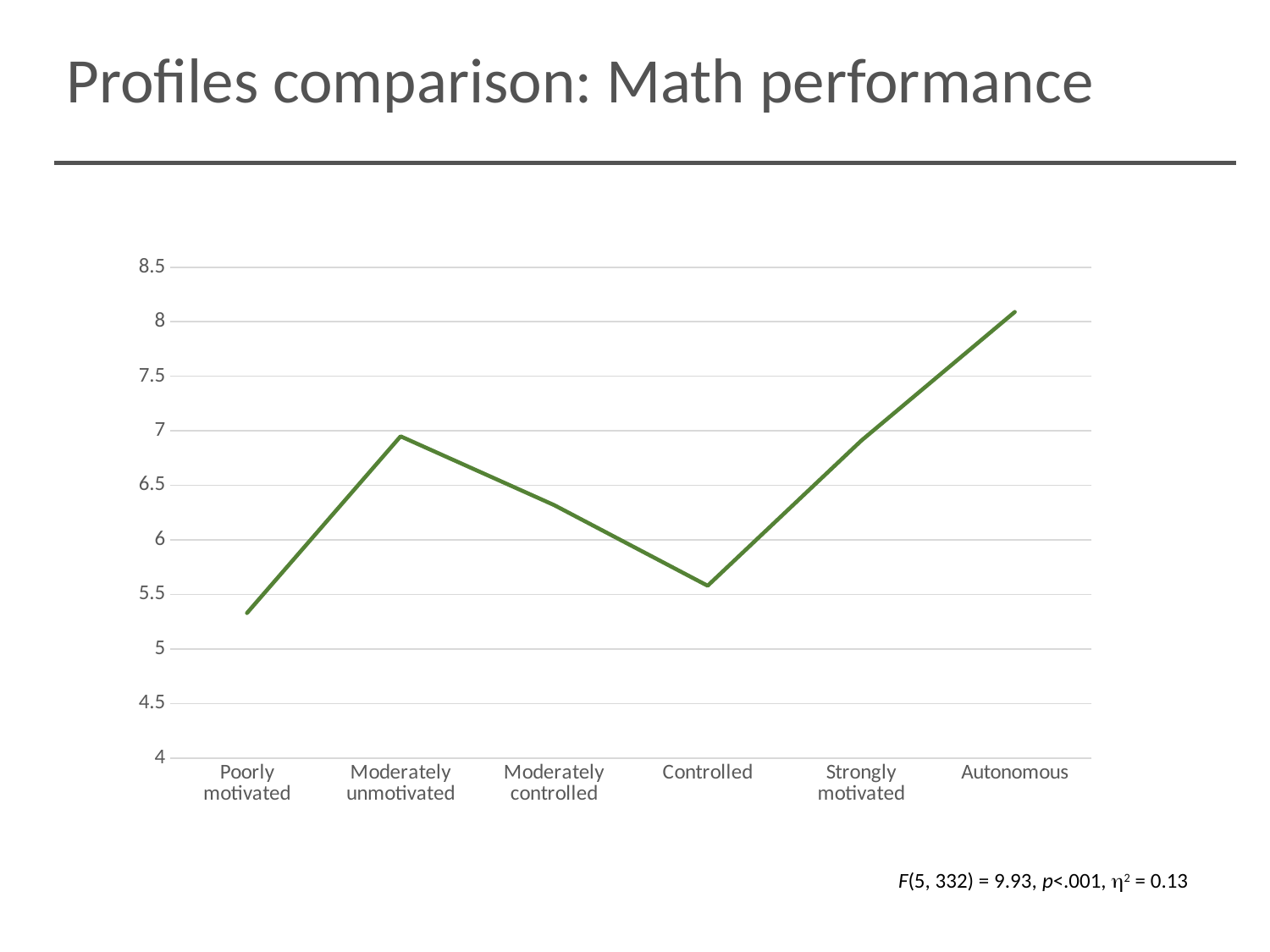
Which has the larger value, Poorly motivated or Controlled? Controlled What kind of chart is shown on the slide? line chart What is the title of the slide containing the chart? Profiles comparison: Math performance Is the value for Autonomous greater or less than 7.5? greater Is the value for Controlled greater or less than 6? less Does the line rise or fall from Controlled to Autonomous? rise Which profile has the highest math performance value? Autonomous How many profile categories are shown on the x axis? 6 Is the value for Moderately unmotivated greater or less than 6.5? greater Which has the larger value, Moderately controlled or Controlled? Moderately controlled Which profile has the lowest math performance value? Poorly motivated